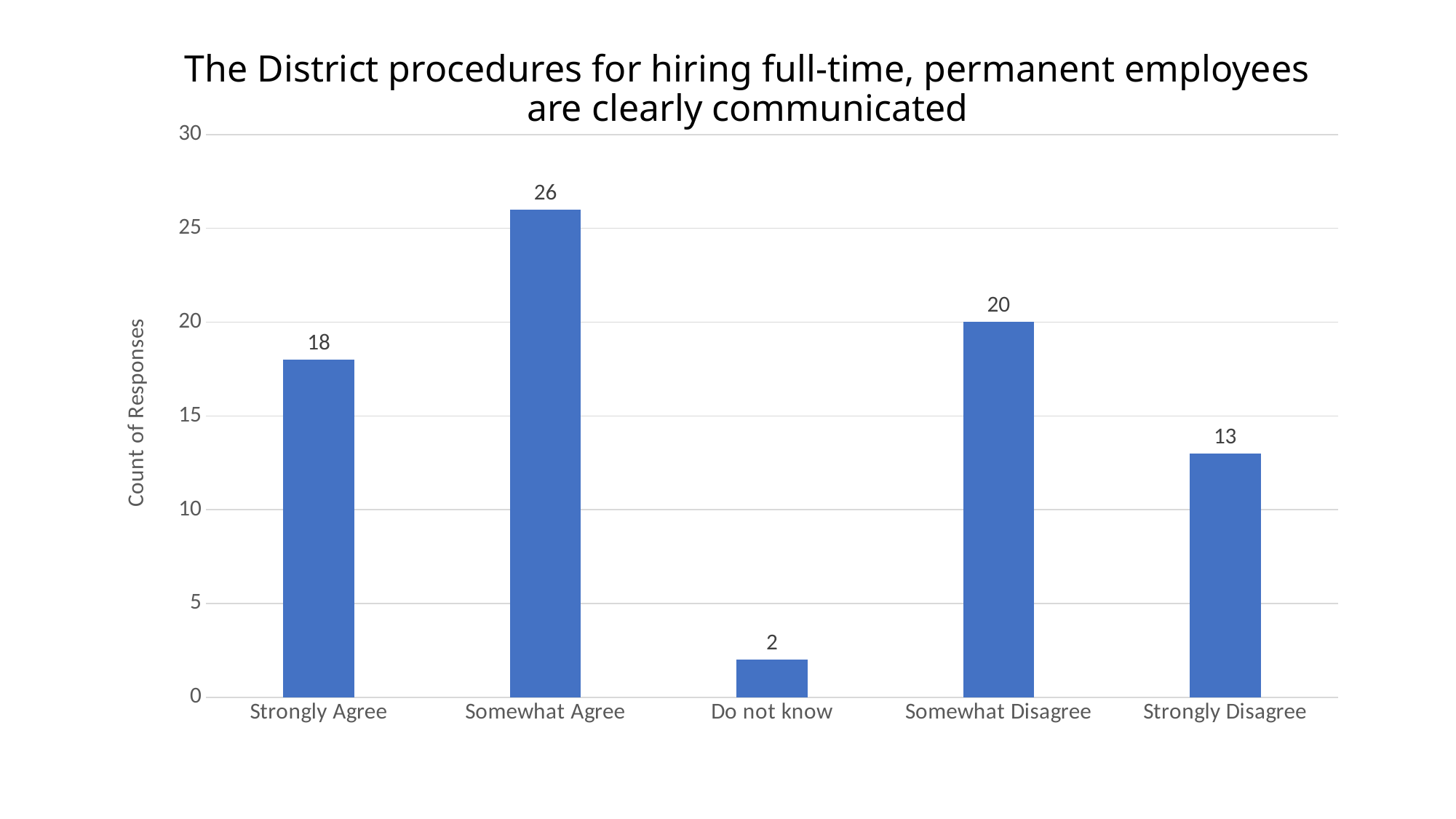
What is the difference between the counts for Somewhat Agree and Somewhat Disagree? 6 What is the count of responses for Somewhat Agree? 26 Which category has the lowest count of responses? Do not know Which has a higher count of responses, Strongly Agree or Strongly Disagree? Strongly Agree What is the count of responses for Do not know? 2 What kind of chart is shown on the slide? Bar chart Is the value for Somewhat Disagree greater or less than 15? greater How many categories are shown on the x axis? 5 What is the count of responses for Strongly Disagree? 13 Which category has the highest count of responses? Somewhat Agree What is the label of the vertical axis? Count of Responses What is the count of responses for Strongly Agree? 18